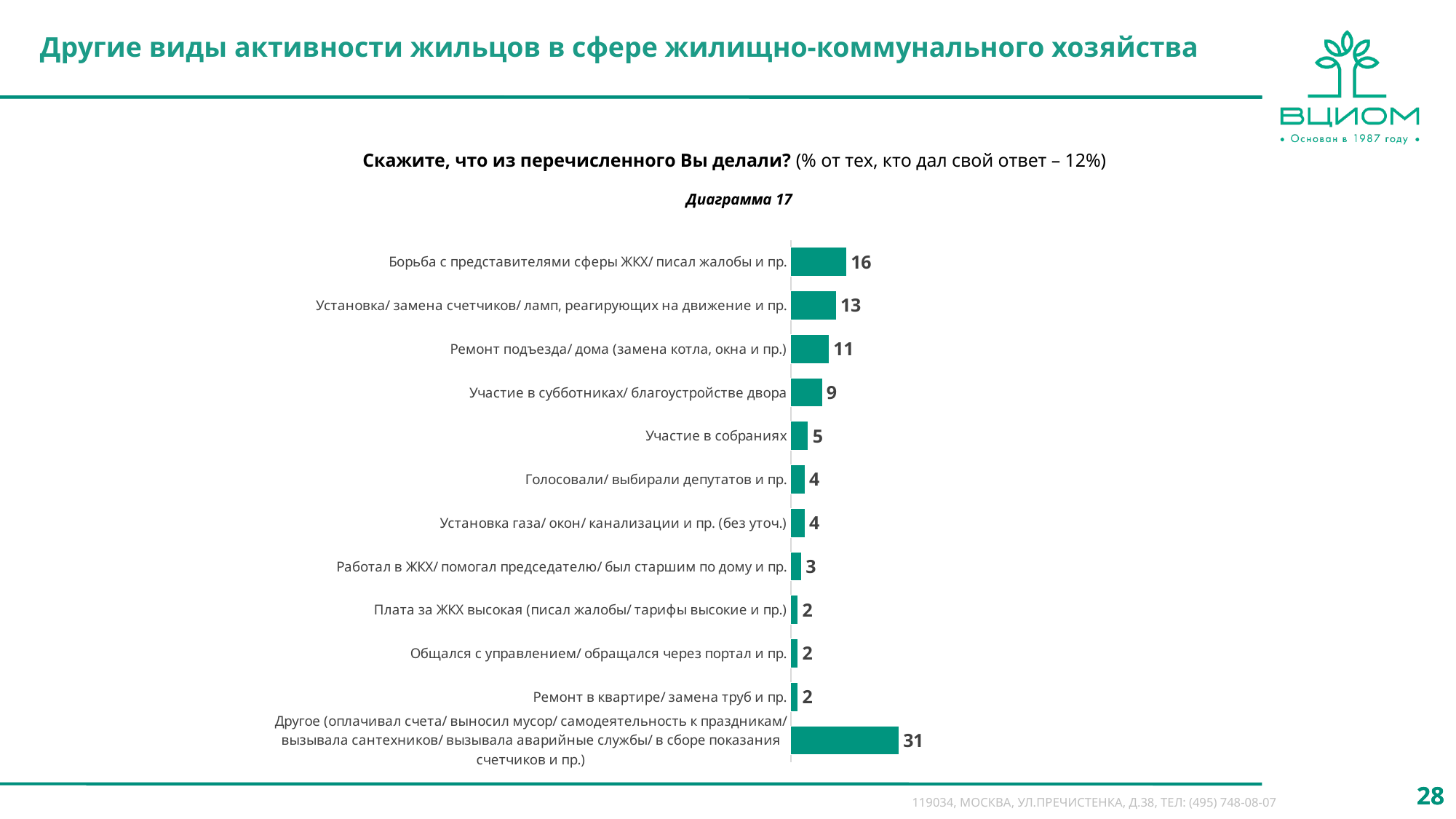
What value is shown for "Ремонт подъезда/ дома (замена котла, окна и пр.)"? 11 What is the difference between the values for "Борьба с представителями сферы ЖКХ/ писал жалобы и пр." and "Установка/ замена счетчиков/ ламп, реагирующих на движение и пр."? 3 What value is shown for "Участие в собраниях"? 5 Which is larger: the value for "Участие в собраниях" or the value for "Работал в ЖКХ/ помогал председателю/ был старшим по дому и пр."? Участие в собраниях How many categories are shown in the chart? 12 What is the diagram number given above the chart? Диаграмма 17 What is the difference between the value for "Другое" and the value for "Борьба с представителями сферы ЖКХ/ писал жалобы и пр."? 15 What value is shown for "Участие в субботниках/ благоустройстве двора"? 9 What value is shown for "Борьба с представителями сферы ЖКХ/ писал жалобы и пр."? 16 What kind of chart is shown on the slide? Bar chart Which category has the highest value? Другое (оплачивал счета/ выносил мусор/ самодеятельность к праздникам/ вызывала сантехников/ вызывала аварийные службы/ в сборе показания счетчиков и пр.) Excluding the "Другое" category, which category has the highest value? Борьба с представителями сферы ЖКХ/ писал жалобы и пр.